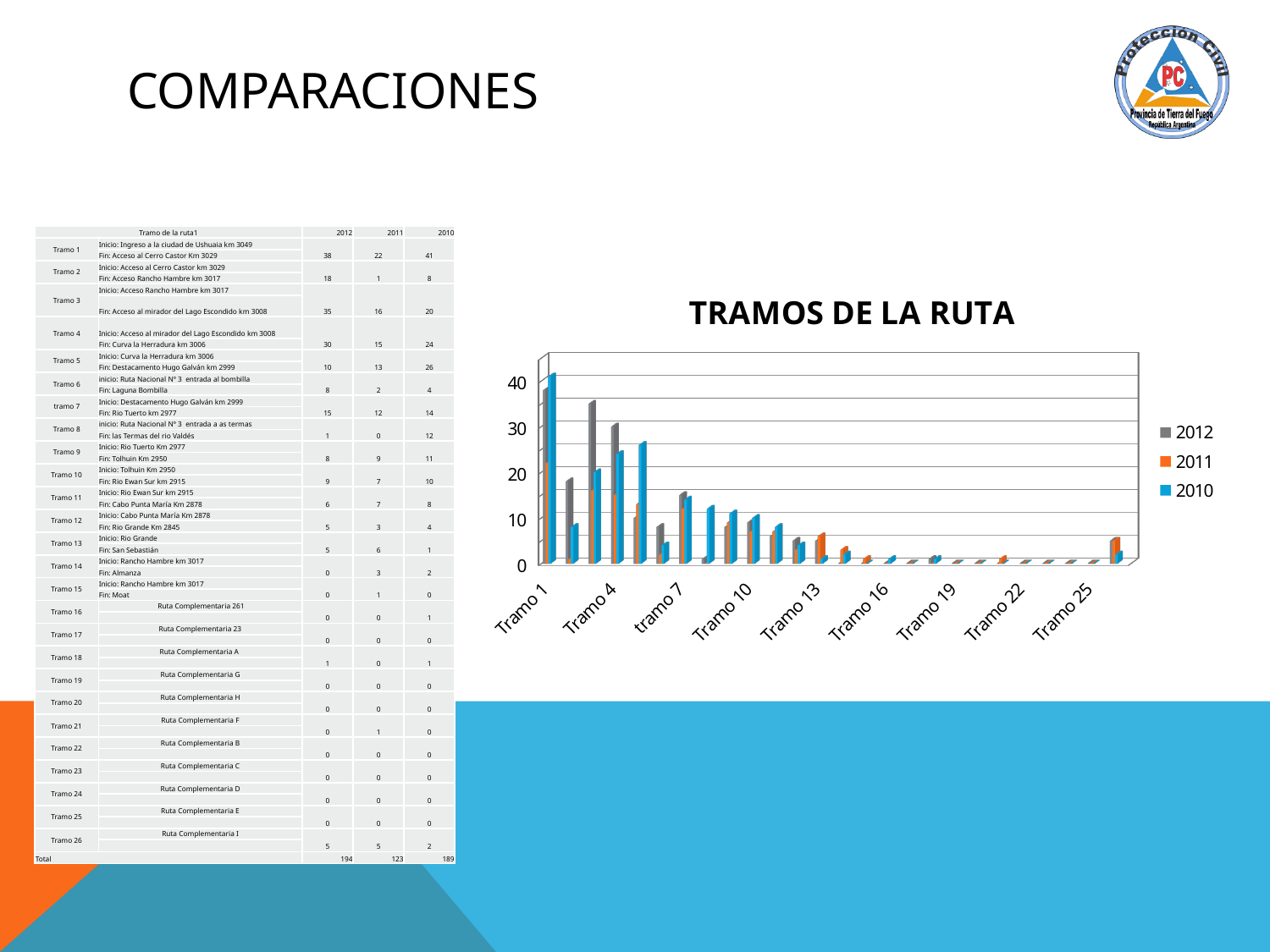
Which years are listed in the legend of the 'TRAMOS DE LA RUTA' chart? 2012, 2011, 2010 What type of chart is 'TRAMOS DE LA RUTA'? bar chart According to the table on the slide, what is the 2012 value for Tramo 1? 38 In the 'TRAMOS DE LA RUTA' chart, is the 2010 value for Tramo 13 greater or less than 10? less In the 'TRAMOS DE LA RUTA' chart, is the 2012 value for Tramo 1 greater or less than 30? greater In the 'TRAMOS DE LA RUTA' chart, which category has the tallest bar overall? Tramo 1 How many series does the legend of the 'TRAMOS DE LA RUTA' chart list? 3 In the 'TRAMOS DE LA RUTA' chart, for Tramo 4, which series has the larger value: 2012 or 2011? 2012 What is the title of the chart on the slide? TRAMOS DE LA RUTA According to the table on the slide, what is the total for 2010? 189 In the 'TRAMOS DE LA RUTA' chart, do the values generally rise or fall from Tramo 1 to Tramo 25? fall